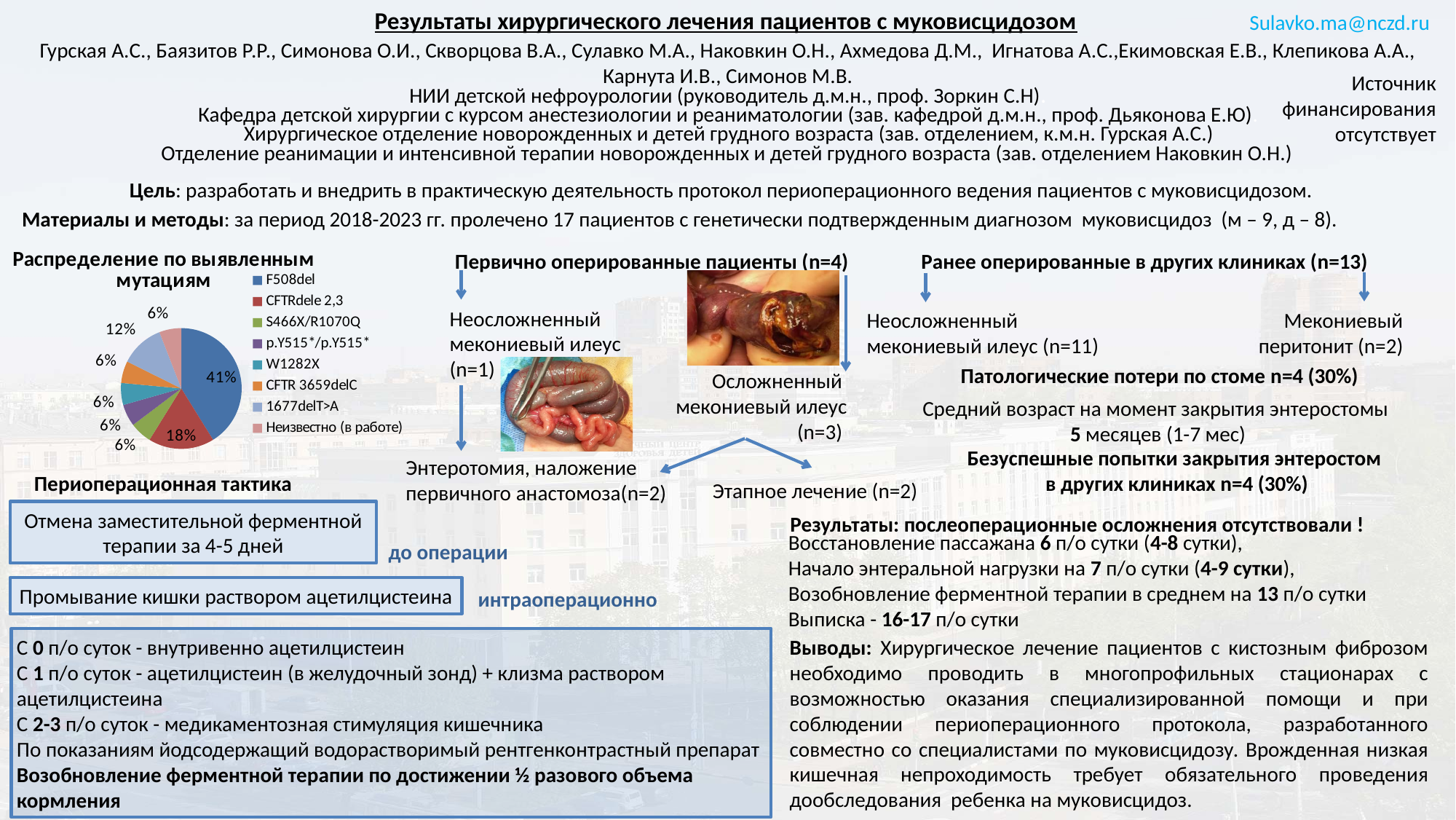
How many categories does the pie chart legend list? 8 What percentage is shown for CFTRdele 2,3 in the pie chart? 18% What is the difference in percentage points between F508del and CFTRdele 2,3 in the pie chart? 23 What kind of chart is used for 'Распределение по выявленным мутациям'? pie chart Which mutation has the largest slice in the pie chart? F508del How many slices in the pie chart are labelled 6%? 5 Which is larger in the pie chart: the share for 1677delT>A or the share for CFTR 3659delC? 1677delT>A What share of the pie chart does F508del account for? 41% What percentage is shown for W1282X in the pie chart? 6% What percentage is shown for 1677delT>A in the pie chart? 12% What is the title of the pie chart? Распределение по выявленным мутациям What is the combined share of F508del and CFTRdele 2,3 in the pie chart? 59%